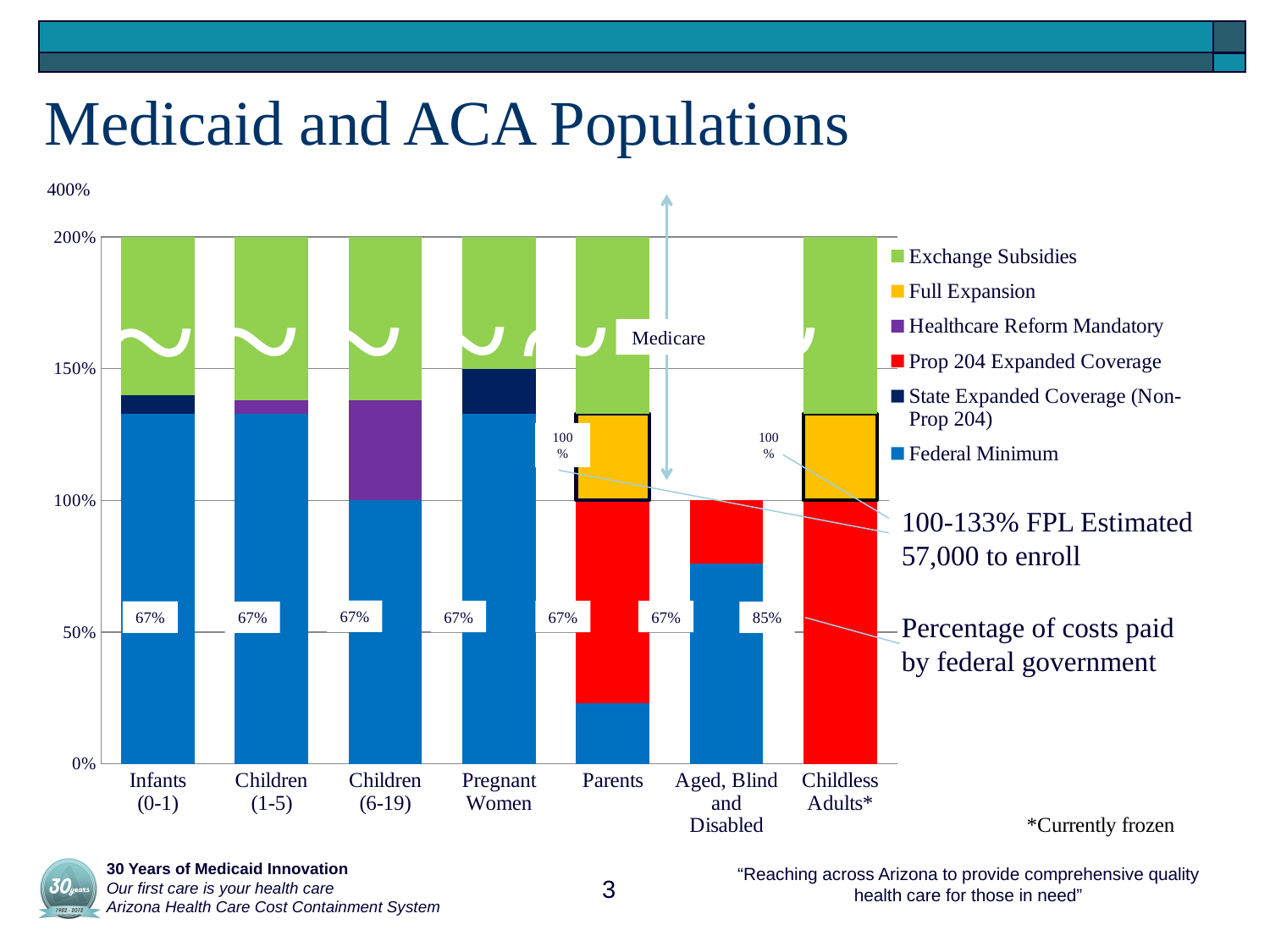
What kind of chart is shown on the slide? Stacked bar chart What is the title of the chart on the slide? Medicaid and ACA Populations What percentage of costs is paid by the federal government for Infants (0-1)? 67% How many series does the chart legend list? 6 Which category has the highest percentage of costs paid by the federal government? Childless Adults* What is the difference between the federal cost percentage for Aged, Blind and Disabled and that for Parents? 0% How many population categories are shown along the x axis of the chart? 7 Is the Federal Minimum value for Parents greater or less than 50%? less Is the Federal Minimum value for Infants (0-1) greater or less than 100%? greater Which is larger, the Federal Minimum value for Infants (0-1) or for Parents? Infants (0-1) What percentage of costs is paid by the federal government for the Aged, Blind and Disabled category? 67% Which category is marked with an asterisk as currently frozen? Childless Adults